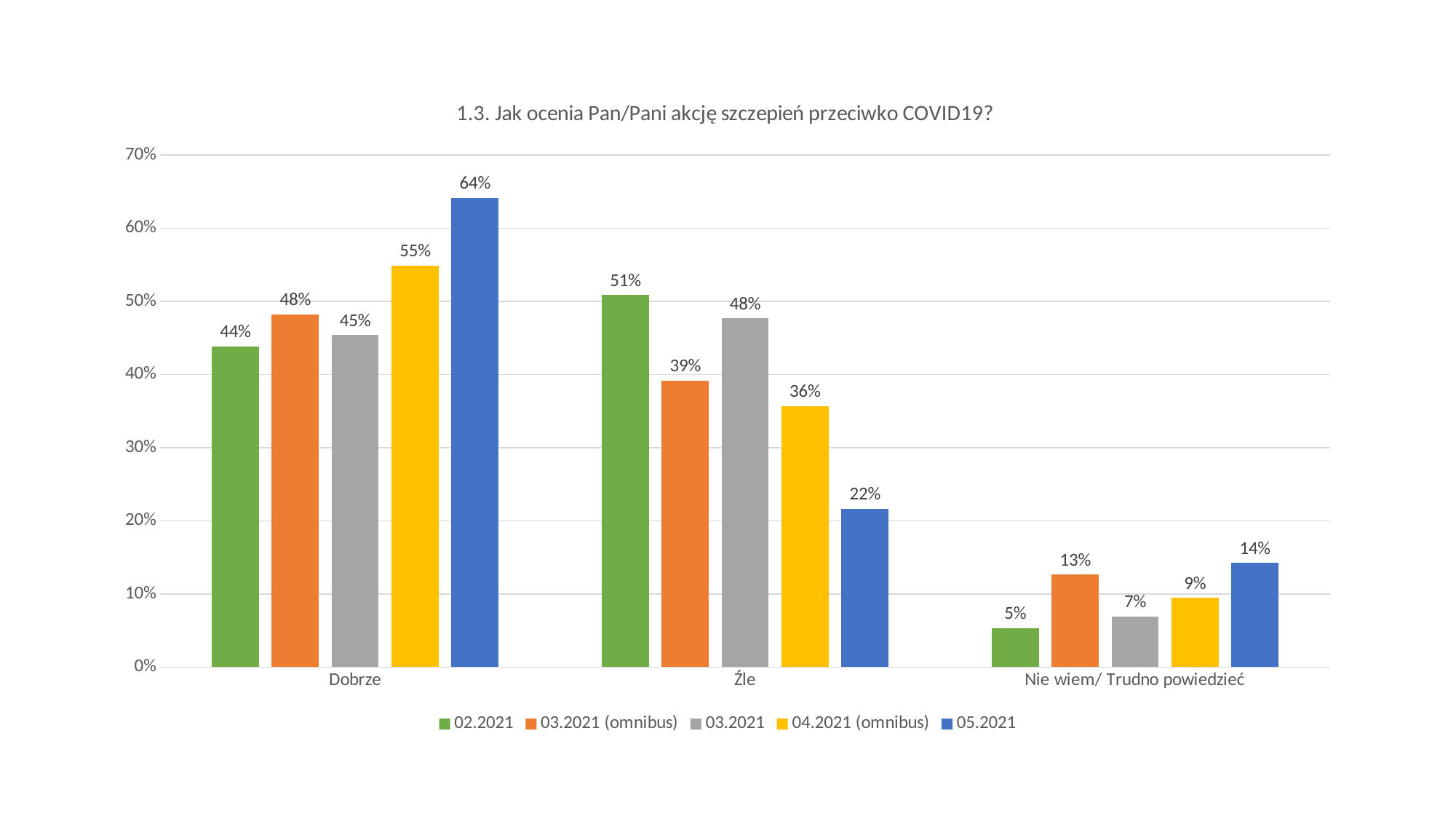
What is the title of the chart? 1.3. Jak ocenia Pan/Pani akcję szczepień przeciwko COVID19? What is the difference between the 05.2021 and 02.2021 values in the Dobrze category? 20% How many categories are shown on the x axis? 3 What is the value for 02.2021 in the Nie wiem/ Trudno powiedzieć category? 5% What is the value for 03.2021 (omnibus) in the Źle category? 39% What kind of chart is shown on the slide? bar chart Which is larger in the Źle category: the value for 02.2021 or the value for 04.2021 (omnibus)? 02.2021 Which series has the highest value in the Dobrze category? 05.2021 Is the value for 03.2021 in the Nie wiem/ Trudno powiedzieć category greater or less than 10%? less Which series has the lowest value in the Źle category? 05.2021 What is the value for 05.2021 in the Dobrze category? 64% How many series does the legend list? 5